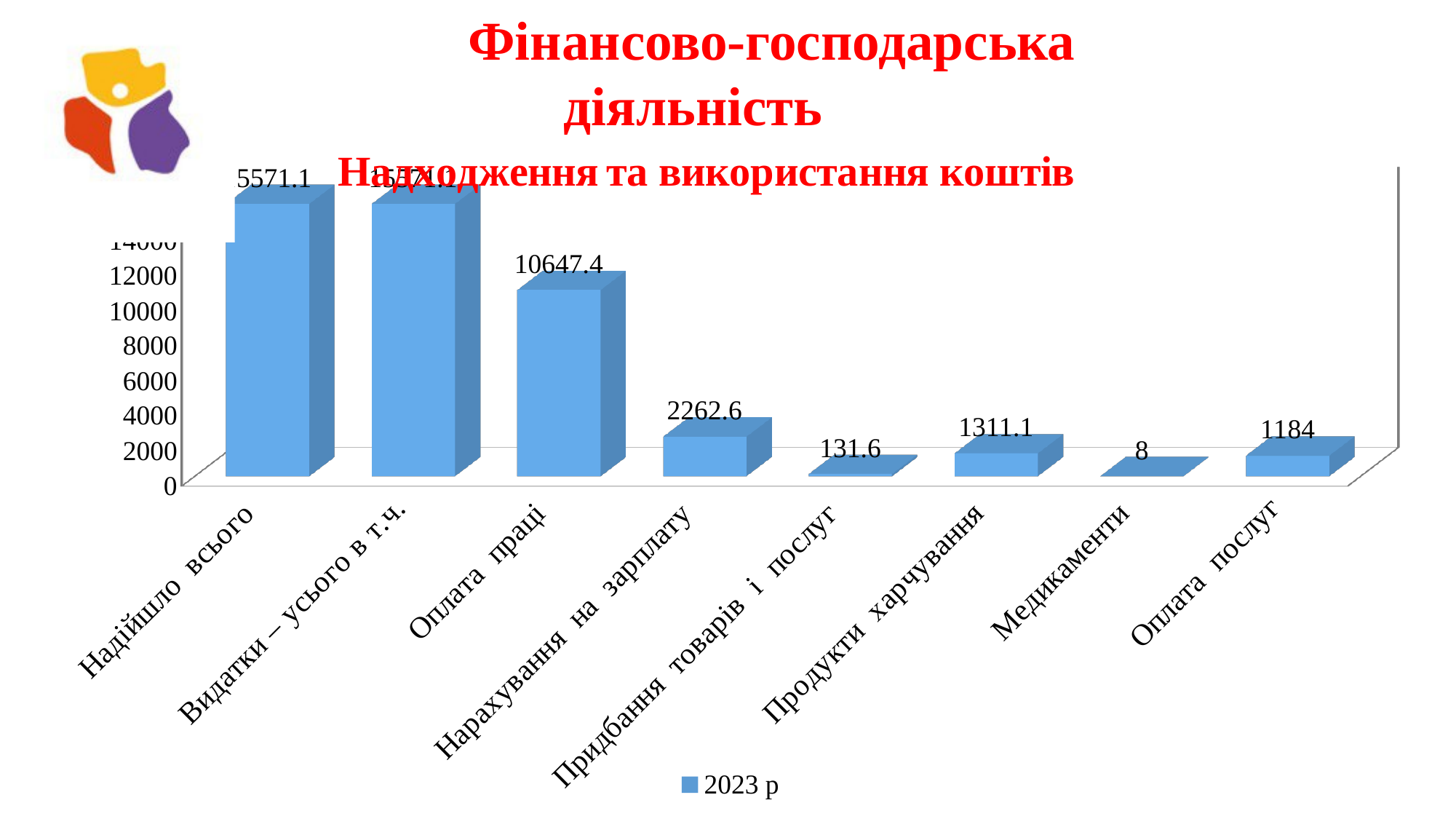
What is the value for Медикаменти? 8 How many categories are shown on the x axis? 8 What is the value for Оплата послуг? 1184 What is the value for Продукти харчування? 1311.1 What is the value for Нарахування на зарплату? 2262.6 What is the value for Придбання товарів і послуг? 131.6 Which is larger, the value for Продукти харчування or the value for Оплата послуг? Продукти харчування Is the value for Надійшло всього greater or less than 14000? greater What series does the legend list? 2023 р Which category has the lowest value? Медикаменти What is the value for Оплата праці? 10647.4 What is the difference between the values for Нарахування на зарплату and Продукти харчування? 951.5